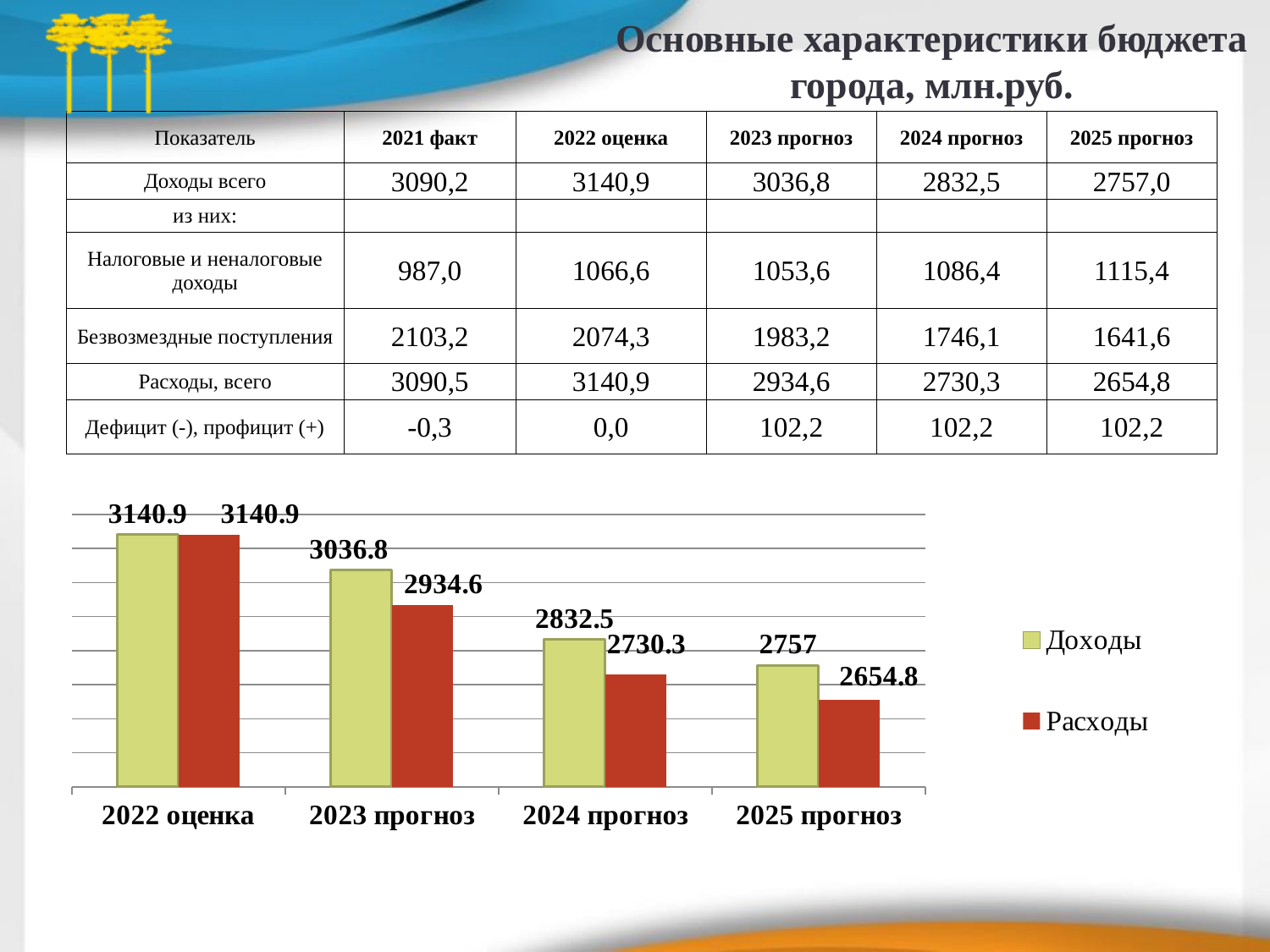
What is the value of Доходы for 2025 прогноз in the chart? 2757 What is the value of Расходы for 2024 прогноз in the chart? 2730.3 What type of chart is shown on the slide? bar chart What is the value of Расходы for 2022 оценка in the chart? 3140.9 Which category has the lowest value for Расходы in the chart? 2025 прогноз Which category has the highest value for Доходы in the chart? 2022 оценка How many series does the chart legend list? 2 Which is larger in the chart: Доходы for 2024 прогноз or Расходы for 2023 прогноз? Расходы for 2023 прогноз Do the Доходы values rise or fall from 2022 оценка to 2025 прогноз in the chart? fall What is the difference between Доходы and Расходы for 2023 прогноз in the chart? 102.2 What is the value of Доходы for 2023 прогноз in the chart? 3036.8 How many categories are shown on the x axis of the chart? 4